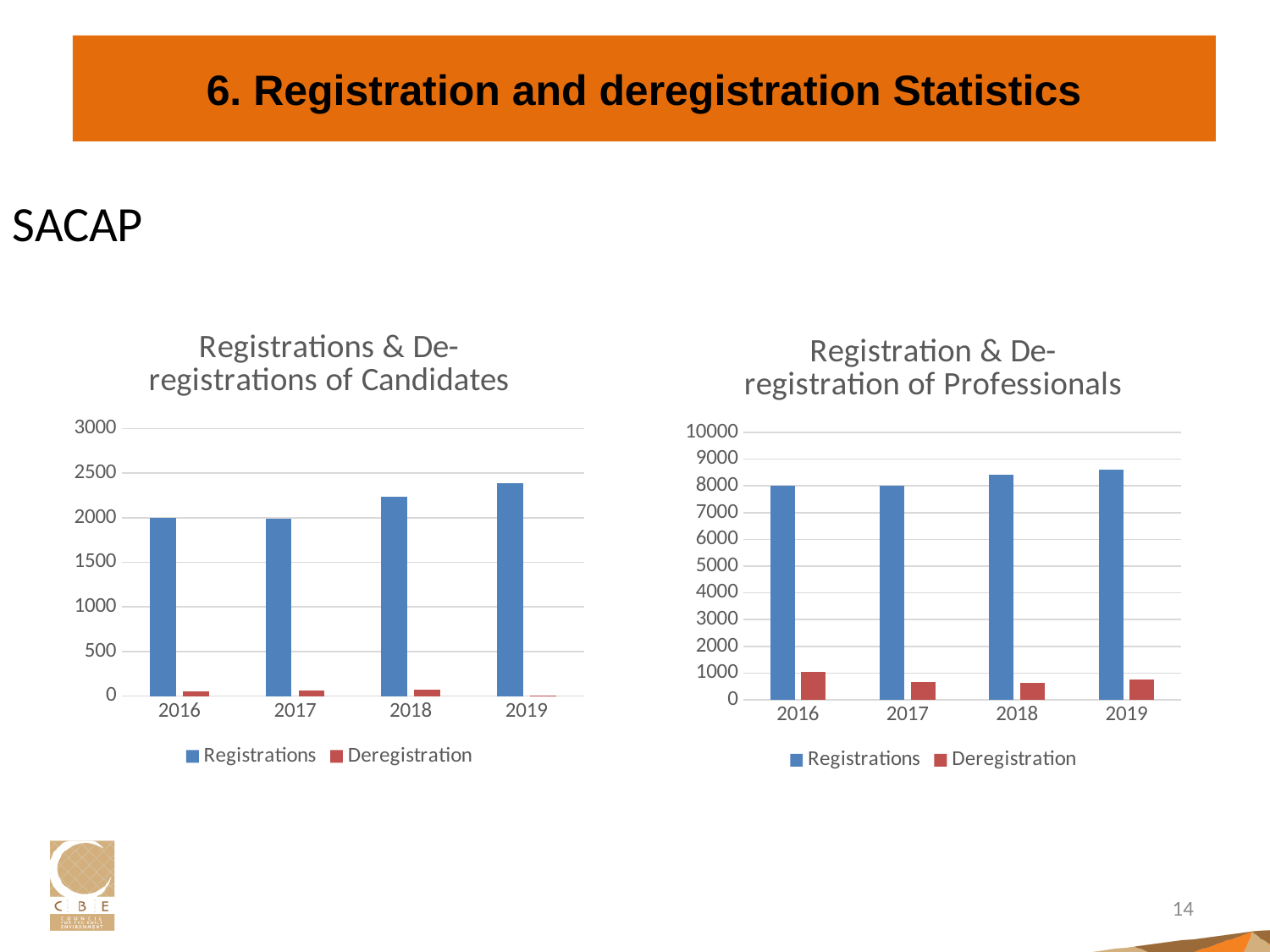
In the 'Registration & De-registration of Professionals' chart, is the Registrations value for 2018 greater or less than 9000? less In the 'Registration & De-registration of Professionals' chart, is the Deregistration value for 2017 greater or less than 1000? less In the 'Registration & De-registration of Professionals' chart, which year has the highest Deregistration value? 2016 In the 'Registration & De-registration of Professionals' chart, which year has the highest number of Registrations? 2019 In the 'Registrations & De-registrations of Candidates' chart, how many years are shown on the x axis? 4 In the 'Registrations & De-registrations of Candidates' chart, is the Registrations value for 2019 greater or less than 2000? greater In the 'Registration & De-registration of Professionals' chart, do Registrations rise or fall from 2017 to 2019? Rise In the 'Registrations & De-registrations of Candidates' chart, which is larger in 2018: Registrations or Deregistration? Registrations In the 'Registration & De-registration of Professionals' chart, how many series does the legend list? 2 What colour represents Deregistration in the legend of the 'Registration & De-registration of Professionals' chart? Red In the 'Registrations & De-registrations of Candidates' chart, what kind of chart is shown? Bar chart In the 'Registrations & De-registrations of Candidates' chart, which year has the highest number of Registrations? 2019